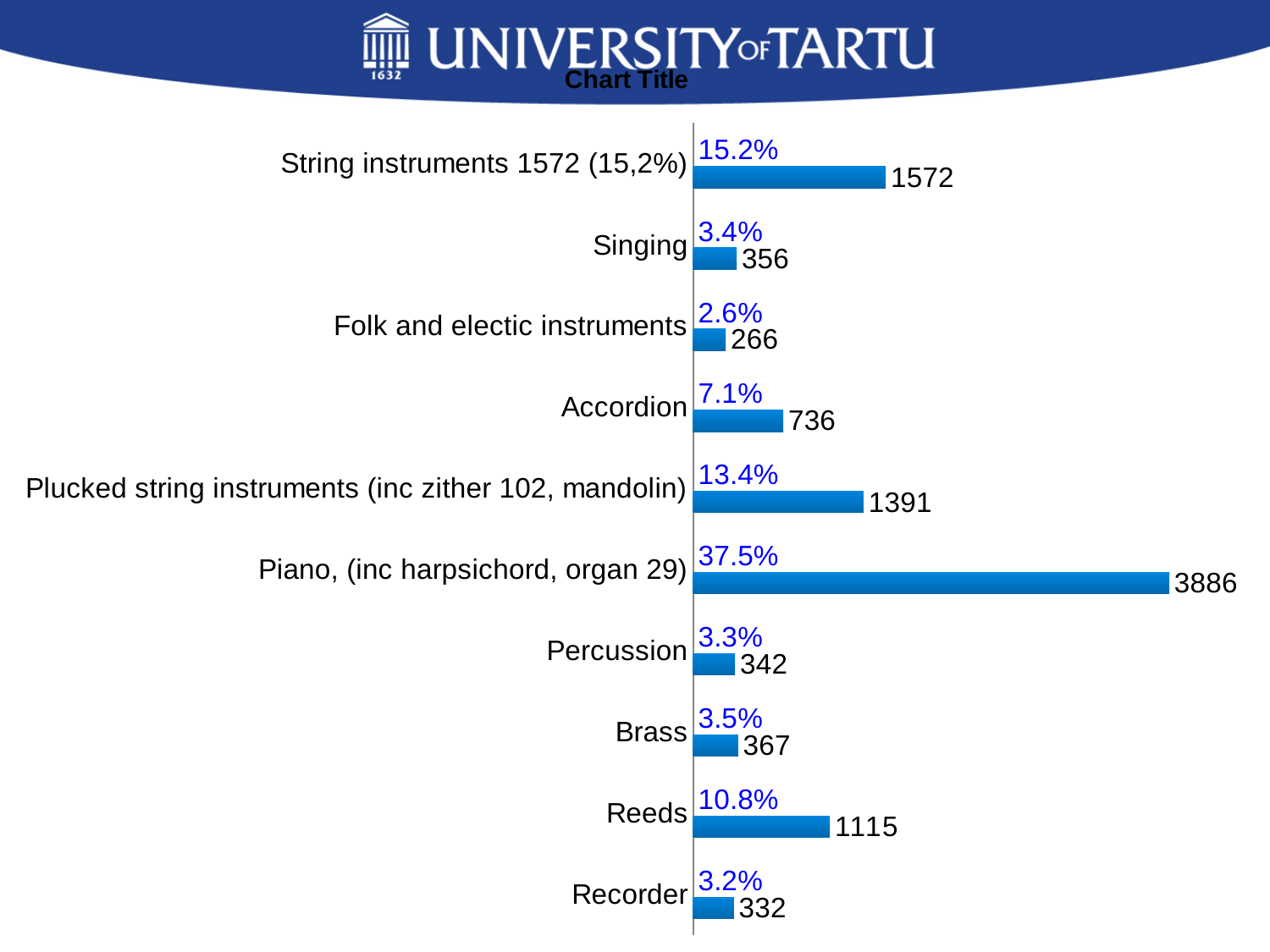
What is the difference between the values for Brass and Percussion? 25 Which category has the highest value? Piano, (inc harpsichord, organ 29) What is the title of the chart? Chart Title Which category has the lowest value? Folk and electic instruments What is the difference between the values for String instruments and Plucked string instruments? 181 What is the value for Piano, (inc harpsichord, organ 29)? 3886 What kind of chart is shown on the slide? Bar chart Which is larger, the value for Singing or the value for Recorder? Singing What percentage is shown for Plucked string instruments (inc zither 102, mandolin)? 13.4% What is the value for Reeds? 1115 What percentage is shown for Accordion? 7.1% How many categories are shown in the chart? 10